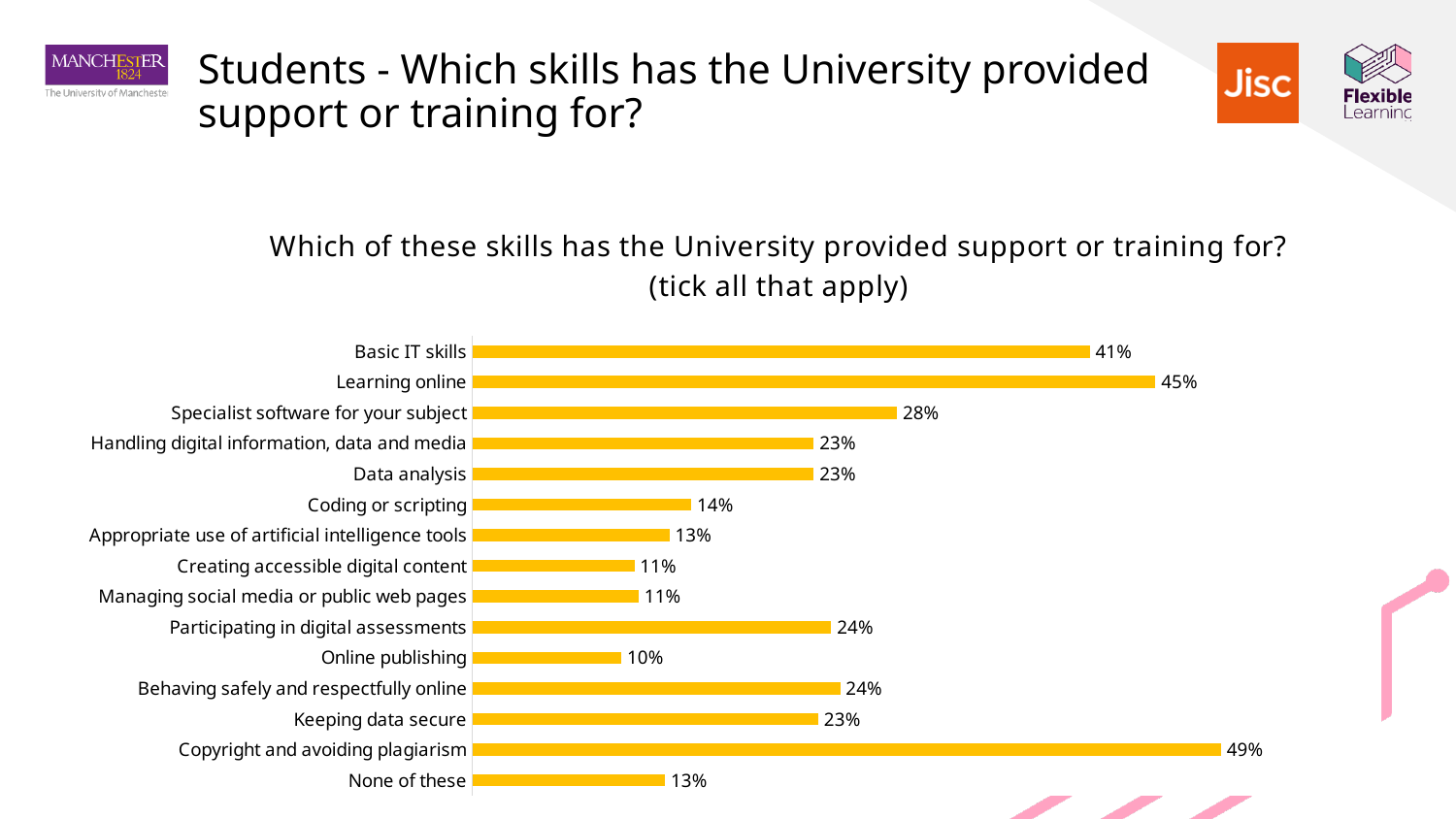
What percentage of students said the University provided support or training for Learning online? 45% Which is larger, the value for Basic IT skills or the value for Specialist software for your subject? Basic IT skills Which skill has the lowest percentage? Online publishing What is the title of the chart? Which of these skills has the University provided support or training for? (tick all that apply) What is the value for Online publishing? 10% What is the difference between the values for Learning online and Specialist software for your subject? 17% How many categories are shown in the chart? 15 What is the value for Coding or scripting? 14% Which is larger, the value for Participating in digital assessments or the value for Appropriate use of artificial intelligence tools? Participating in digital assessments Which skill has the highest percentage? Copyright and avoiding plagiarism What kind of chart is shown on the slide? Bar chart What is the difference between the values for Copyright and avoiding plagiarism and Basic IT skills? 8%